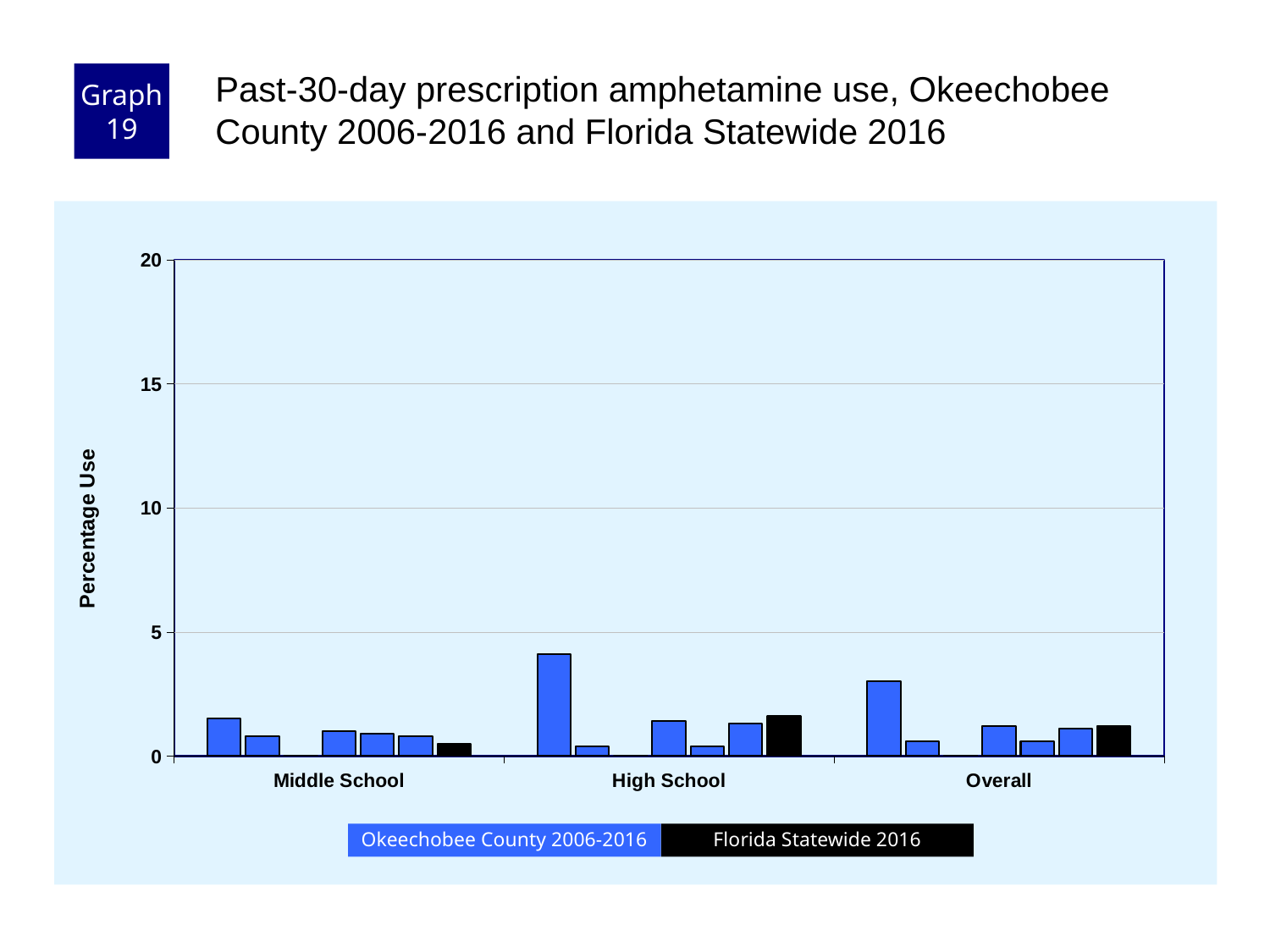
Which colour represents Florida Statewide 2016 in the legend? Black Is the tallest Okeechobee County bar in the High School group greater or less than 5? less Is the Florida Statewide 2016 value for High School greater or less than 5? less How many series does the legend list? 2 Which category has the highest Florida Statewide 2016 value? High School What kind of chart is shown on the slide? Bar chart Which category contains the tallest bar in the chart? High School How many categories are shown on the x axis? 3 What is the label on the y axis? Percentage Use Is the Florida Statewide 2016 value for Middle School greater or less than 5? less Which category has the lowest Florida Statewide 2016 value? Middle School Is the Florida Statewide 2016 value larger for High School or for Middle School? High School